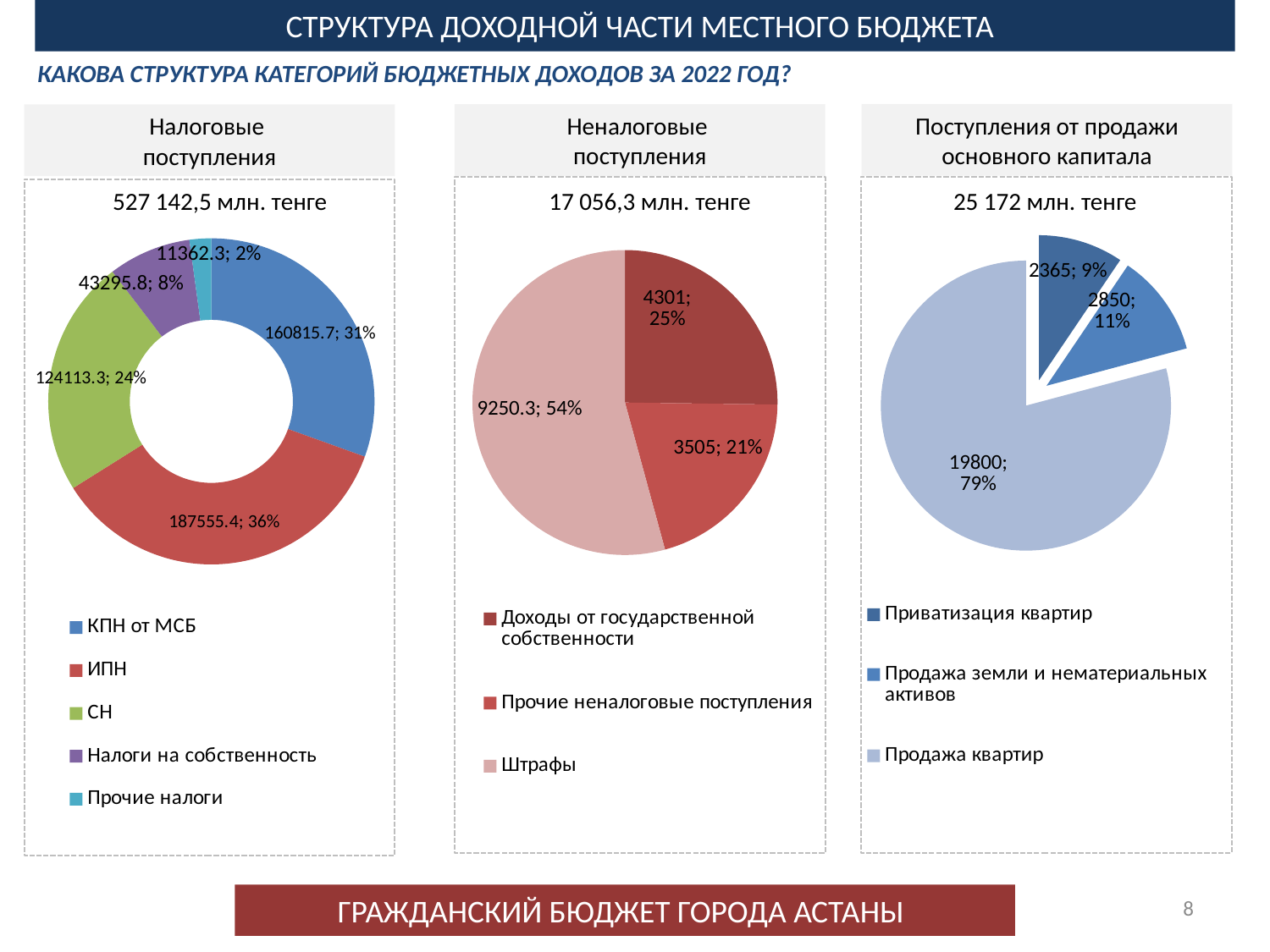
What type of chart is used for 'Налоговые поступления'? Doughnut chart In the 'Налоговые поступления' chart, which category has the largest share? ИПН How many categories does the legend of the 'Налоговые поступления' chart list? 5 In the 'Неналоговые поступления' chart, what is the difference between the values for Доходы от государственной собственности and Прочие неналоговые поступления? 796 In the 'Налоговые поступления' chart, what percentage share is shown for СН? 24% In the 'Налоговые поступления' chart, what value and share are shown for ИПН? 187555.4; 36% In the 'Налоговые поступления' chart, which category has the smallest share? Прочие налоги In the 'Неналоговые поступления' chart, which is larger: Доходы от государственной собственности or Прочие неналоговые поступления? Доходы от государственной собственности In the 'Поступления от продажи основного капитала' chart, what value and share are shown for Продажа квартир? 19800; 79% What total amount is shown above the 'Неналоговые поступления' chart? 17 056,3 млн. тенге In the 'Поступления от продажи основного капитала' chart, which category has the smallest share? Приватизация квартир In the 'Неналоговые поступления' chart, what value and share are shown for Штрафы? 9250.3; 54%